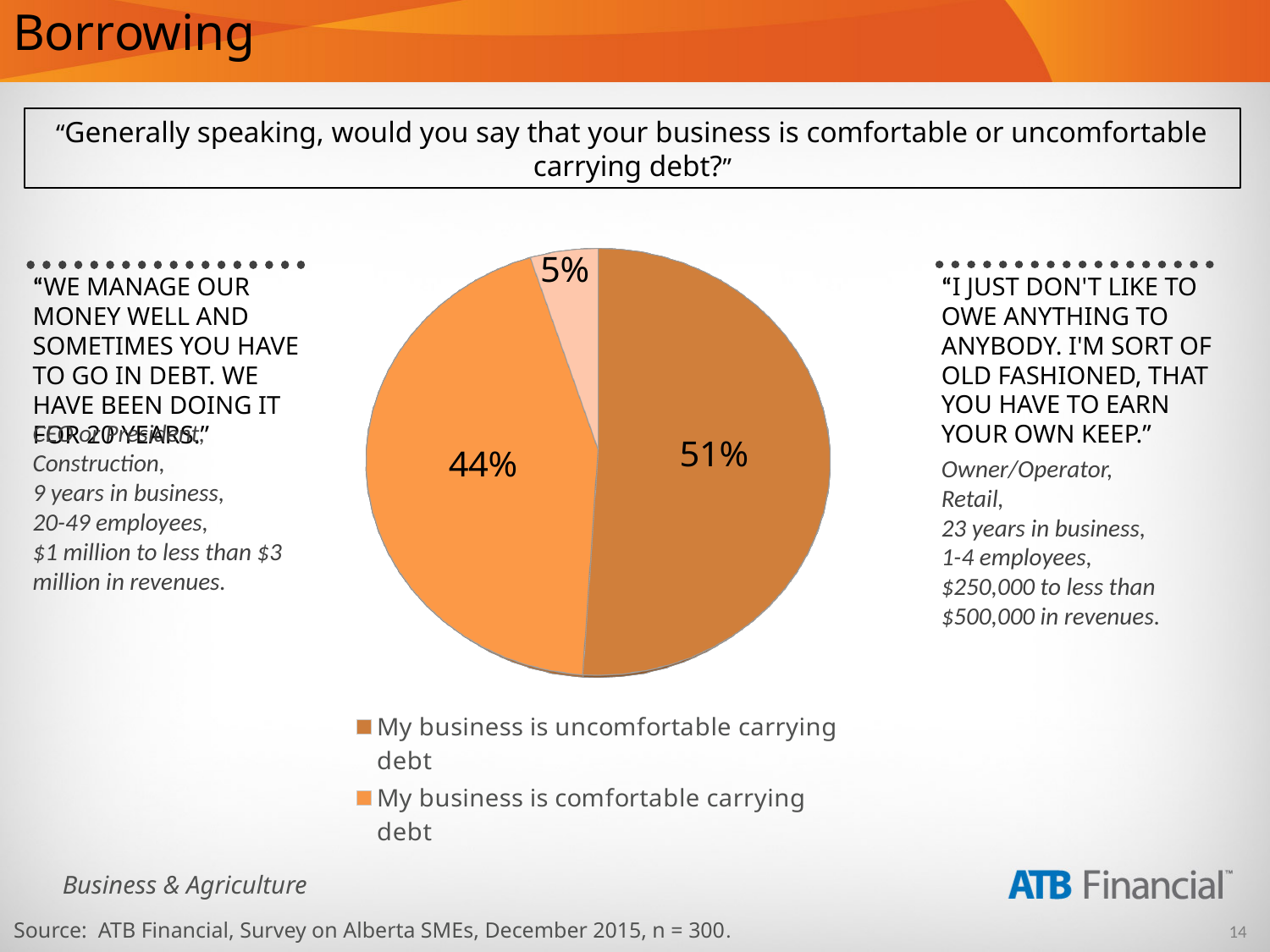
What is the difference in percentage points between the 'uncomfortable carrying debt' slice and the 'comfortable carrying debt' slice? 7 What percentage of respondents said their business is comfortable carrying debt? 44% What is the value shown on the smallest slice of the pie chart? 5% What share of the pie does the 'My business is uncomfortable carrying debt' slice represent? 51% How many slices does the pie chart have? 3 Is the share for 'My business is comfortable carrying debt' greater or less than 50%? less What percentage of respondents said their business is uncomfortable carrying debt? 51% What kind of chart is shown on the slide? pie chart Which response has the largest share of the pie chart? My business is uncomfortable carrying debt How many entries does the legend list? 2 Which is larger: the share for 'My business is uncomfortable carrying debt' or the share for 'My business is comfortable carrying debt'? My business is uncomfortable carrying debt What is the survey question shown above the chart? Generally speaking, would you say that your business is comfortable or uncomfortable carrying debt?